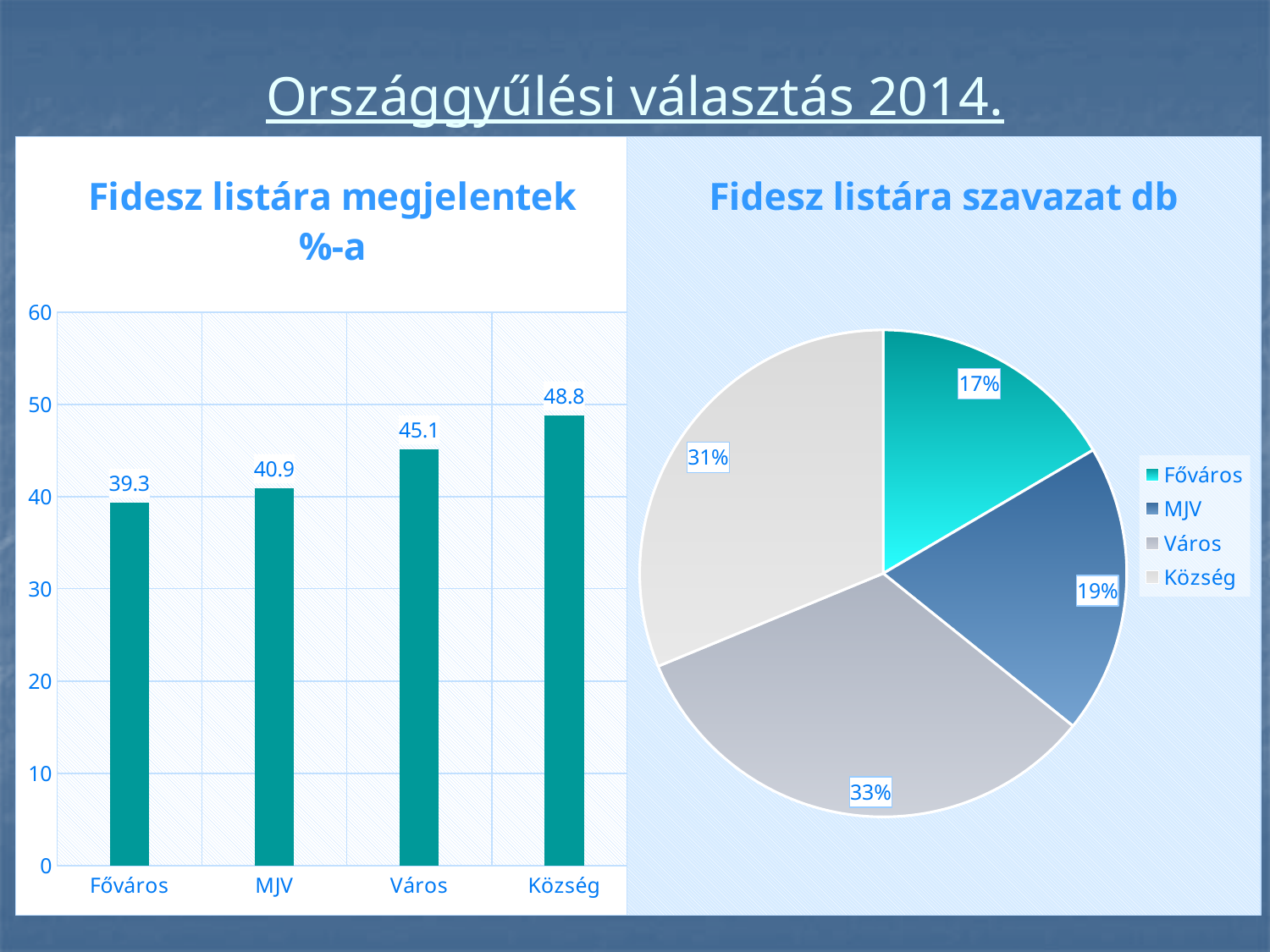
In the 'Fidesz listára megjelentek %-a' chart, what is the value for Község? 48.8 In the 'Fidesz listára megjelentek %-a' chart, what is the difference between the values for Község and Főváros? 9.5 In the 'Fidesz listára megjelentek %-a' chart, which category has the highest value? Község In the 'Fidesz listára megjelentek %-a' chart, what is the value for Főváros? 39.3 In the 'Fidesz listára megjelentek %-a' chart, which is larger, the value for MJV or the value for Város? Város In the 'Fidesz listára szavazat db' pie chart, which category has the smallest slice? Főváros In the 'Fidesz listára megjelentek %-a' chart, do the values rise or fall from Főváros to Község? rise How many entries does the legend of the 'Fidesz listára szavazat db' pie chart list? 4 In the 'Fidesz listára szavazat db' pie chart, what share does Város have? 33% In the 'Fidesz listára megjelentek %-a' chart, how many categories are shown on the x axis? 4 What kind of chart is 'Fidesz listára megjelentek %-a'? bar chart In the 'Fidesz listára megjelentek %-a' chart, which category has the lowest value? Főváros